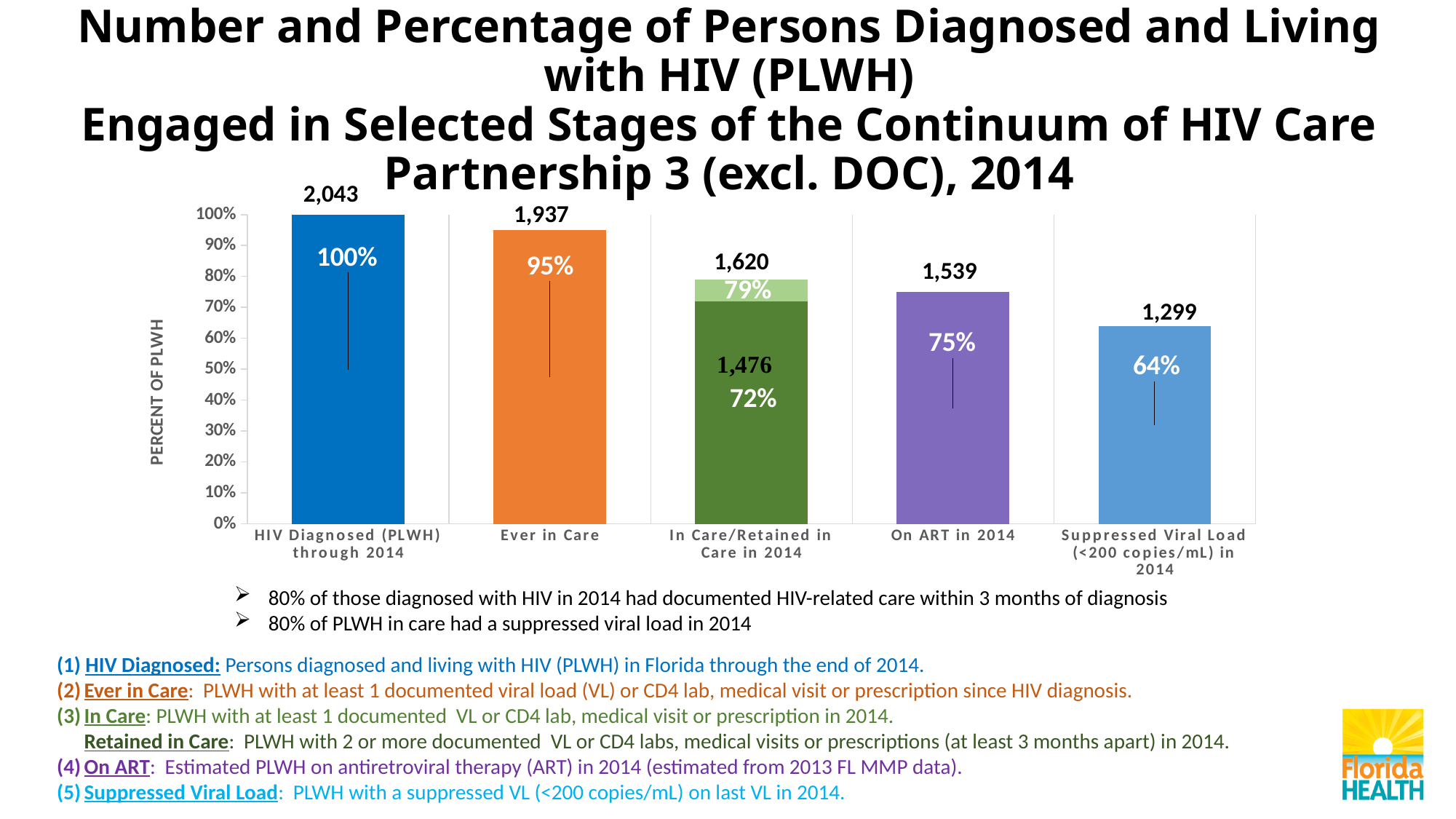
What is the label of the y axis? PERCENT OF PLWH Which category has the highest number of persons? HIV Diagnosed (PLWH) through 2014 What number is shown for the 'Retained in Care' portion (darker green) of the 'In Care/Retained in Care in 2014' bar? 1,476 How many categories are shown on the x axis of the chart? 5 What percentage is shown for the 'In Care' portion (top of the green bar) in 2014? 79% Which is larger: the number for 'On ART in 2014' or the number for 'Suppressed Viral Load (<200 copies/mL) in 2014'? On ART in 2014 Which category has the lowest number of persons? Suppressed Viral Load (<200 copies/mL) in 2014 What is the difference in number of persons between 'Ever in Care' and 'On ART in 2014'? 398 What is the number of persons shown for the 'HIV Diagnosed (PLWH) through 2014' bar? 2,043 What percentage is shown for 'Suppressed Viral Load (<200 copies/mL) in 2014'? 64% What percentage is shown for the 'Ever in Care' bar? 95% What number is shown above the 'On ART in 2014' bar? 1,539